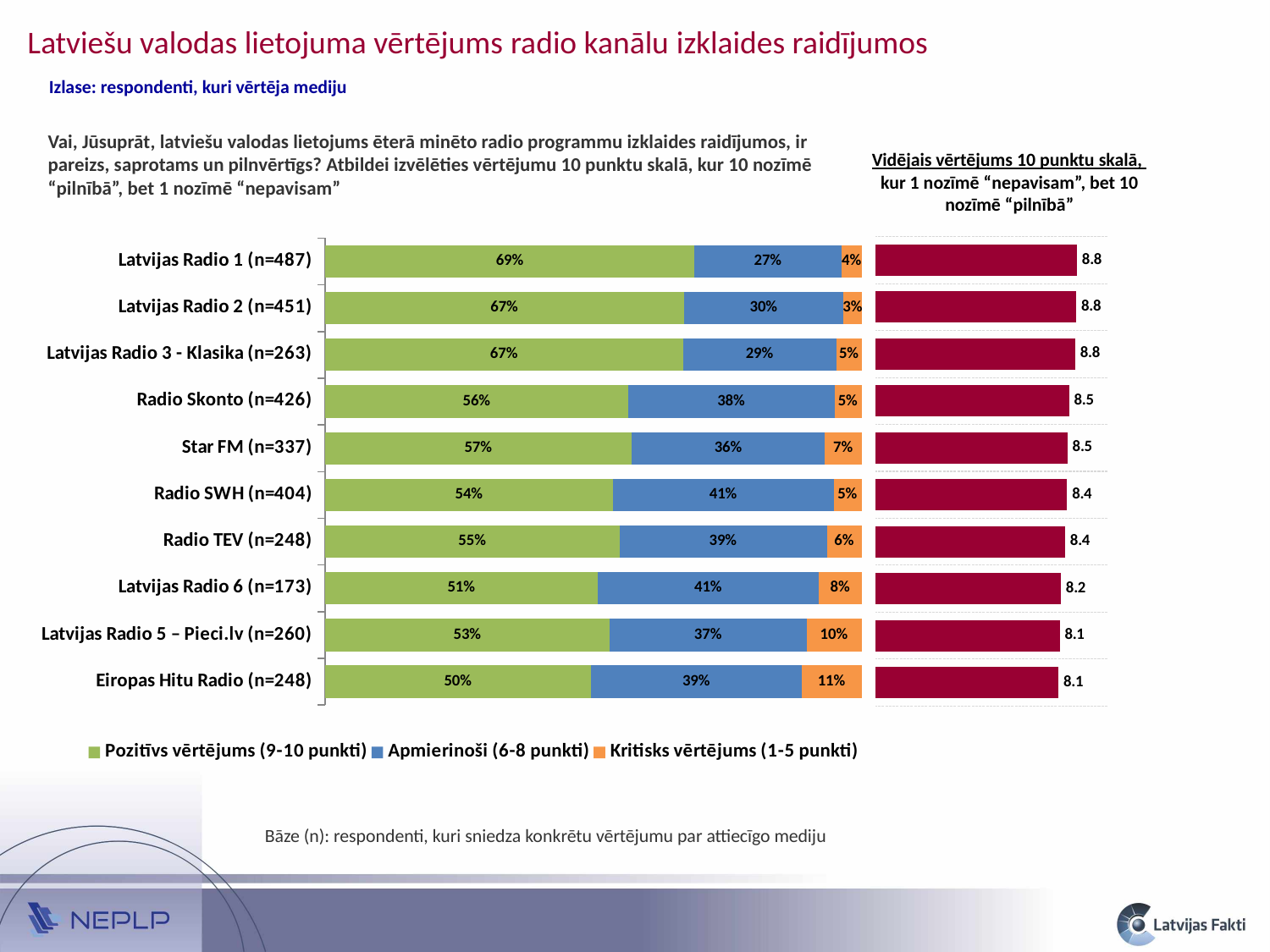
In the stacked bar chart on the left, which has a larger Pozitīvs vērtējums (9-10 punkti) share: Radio TEV (n=248) or Latvijas Radio 6 (n=173)? Radio TEV (n=248) In the stacked bar chart on the left, which radio station has the highest Pozitīvs vērtējums (9-10 punkti) share? Latvijas Radio 1 (n=487) In the chart titled 'Vidējais vērtējums 10 punktu skalā' on the right, what is the value for Radio Skonto (n=426)? 8.5 In the stacked bar chart on the left, what is the difference between the Apmierinoši (6-8 punkti) value for Radio SWH (n=404) and for Latvijas Radio 1 (n=487)? 14 percentage points In the chart titled 'Vidējais vērtējums 10 punktu skalā' on the right, what is the difference between the value for Latvijas Radio 1 (n=487) and Eiropas Hitu Radio (n=248)? 0.7 In the stacked bar chart on the left, what is the value of Pozitīvs vērtējums (9-10 punkti) for Latvijas Radio 1 (n=487)? 69% In the stacked bar chart on the left, which radio station has the lowest Pozitīvs vērtējums (9-10 punkti) share? Eiropas Hitu Radio (n=248) What kind of chart is the chart on the left of the slide? Stacked bar chart In the stacked bar chart on the left, what is the value of Kritisks vērtējums (1-5 punkti) for Eiropas Hitu Radio (n=248)? 11% In the stacked bar chart on the left, which radio station has the highest Kritisks vērtējums (1-5 punkti) share? Eiropas Hitu Radio (n=248) How many radio stations are listed in the stacked bar chart on the left? 10 How many series does the legend of the stacked bar chart on the left list? 3